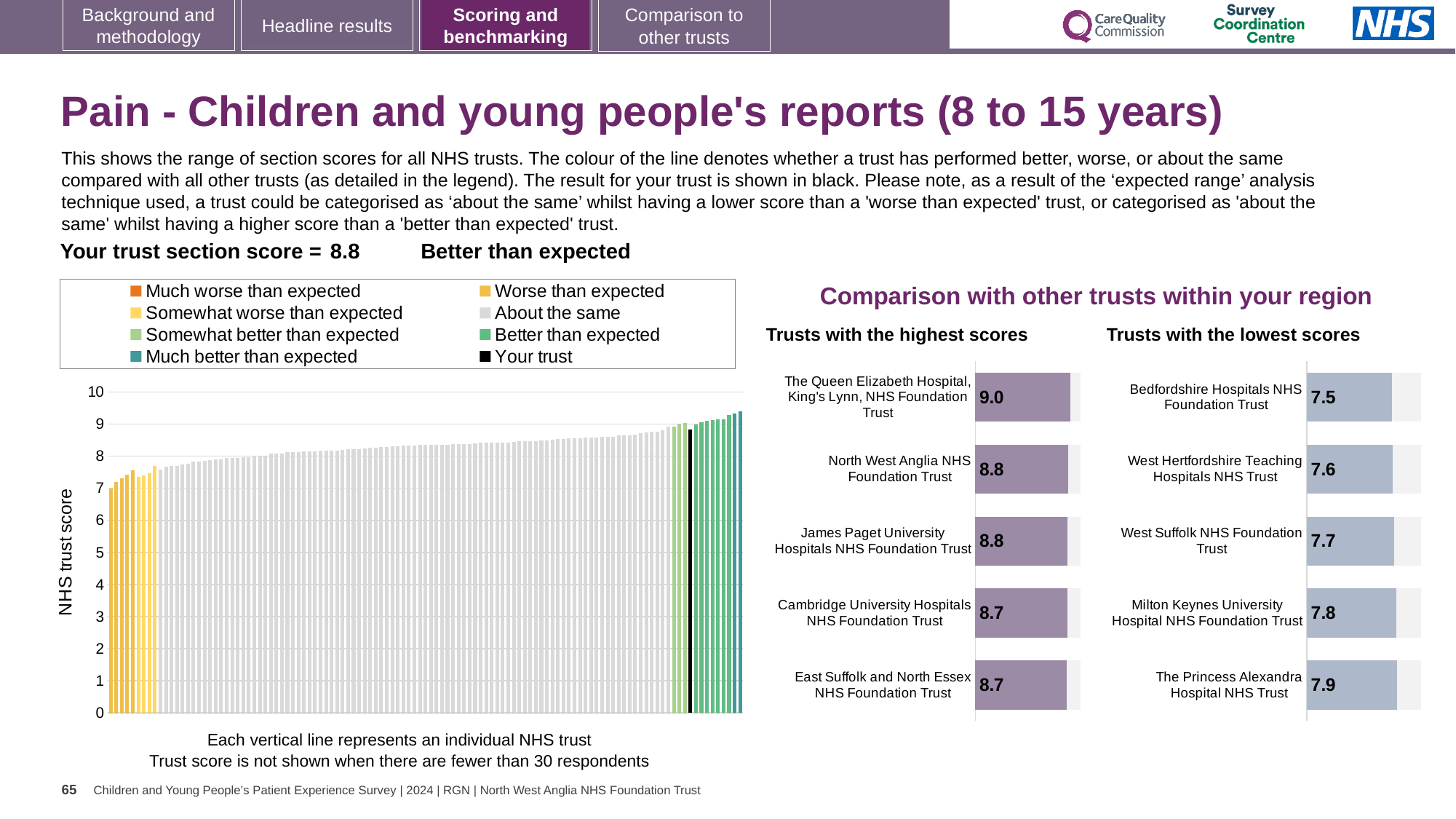
On the 'Trusts with the highest scores' chart, what is the difference between the scores of The Queen Elizabeth Hospital, King's Lynn and Cambridge University Hospitals? 0.3 On the 'Trusts with the lowest scores' chart, what is the score for Milton Keynes University Hospital NHS Foundation Trust? 7.8 On the 'Trusts with the highest scores' chart, which trust has the highest score? The Queen Elizabeth Hospital, King's Lynn, NHS Foundation Trust On the 'Trusts with the lowest scores' chart, what is the score for Bedfordshire Hospitals NHS Foundation Trust? 7.5 On the large 'NHS trust score' chart on the left, is the value of the black 'Your trust' bar greater or less than 8? greater On the 'Trusts with the lowest scores' chart, what is the difference between the scores of The Princess Alexandra Hospital NHS Trust and Bedfordshire Hospitals NHS Foundation Trust? 0.4 On the 'Trusts with the lowest scores' chart, which trust has the lowest score? Bedfordshire Hospitals NHS Foundation Trust On the 'Trusts with the highest scores' chart, what is the score for Cambridge University Hospitals NHS Foundation Trust? 8.7 How many entries does the legend of the large 'NHS trust score' chart on the left list? 8 How many trusts are shown on the 'Trusts with the highest scores' chart? 5 On the 'Trusts with the highest scores' chart, what is the score for The Queen Elizabeth Hospital, King's Lynn, NHS Foundation Trust? 9.0 On the 'Trusts with the lowest scores' chart, which has the higher score: West Suffolk NHS Foundation Trust or Milton Keynes University Hospital NHS Foundation Trust? Milton Keynes University Hospital NHS Foundation Trust